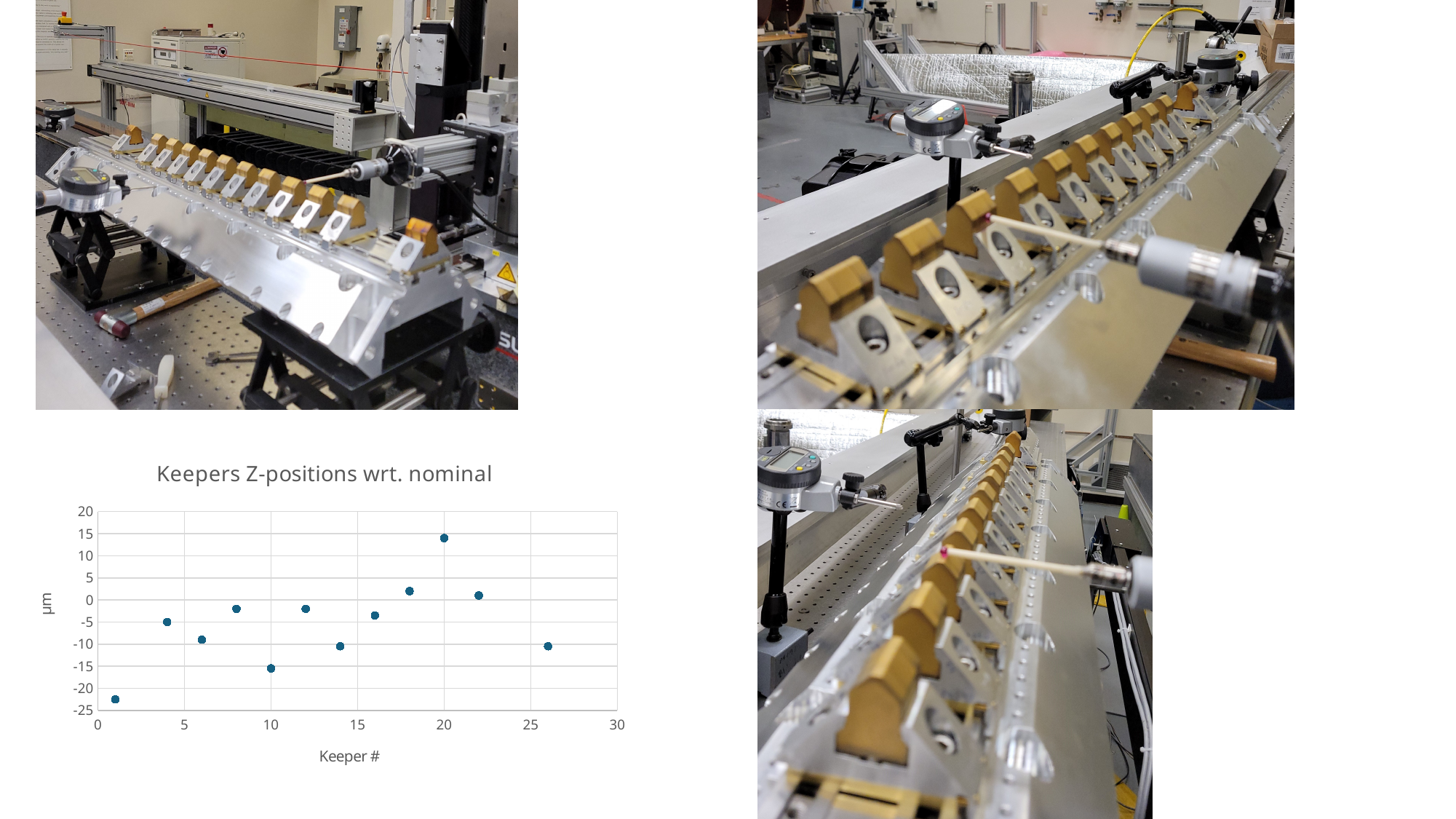
Which has the larger value, keeper 1 or keeper 10? keeper 10 Is the value for keeper 18 greater or less than 0? greater Is the value for keeper 10 greater or less than -10? less Is the value for keeper 20 greater or less than 10? greater What type of chart is shown on the slide? scatter chart Which keeper number has the lowest Z-position value in the chart? 1 Which keeper number has the highest Z-position value in the chart? 20 Which has the larger value, keeper 20 or keeper 18? keeper 20 How many data points are plotted in the chart? 12 What is the label of the x axis of the chart? Keeper # What is the title of the chart? Keepers Z-positions wrt. nominal